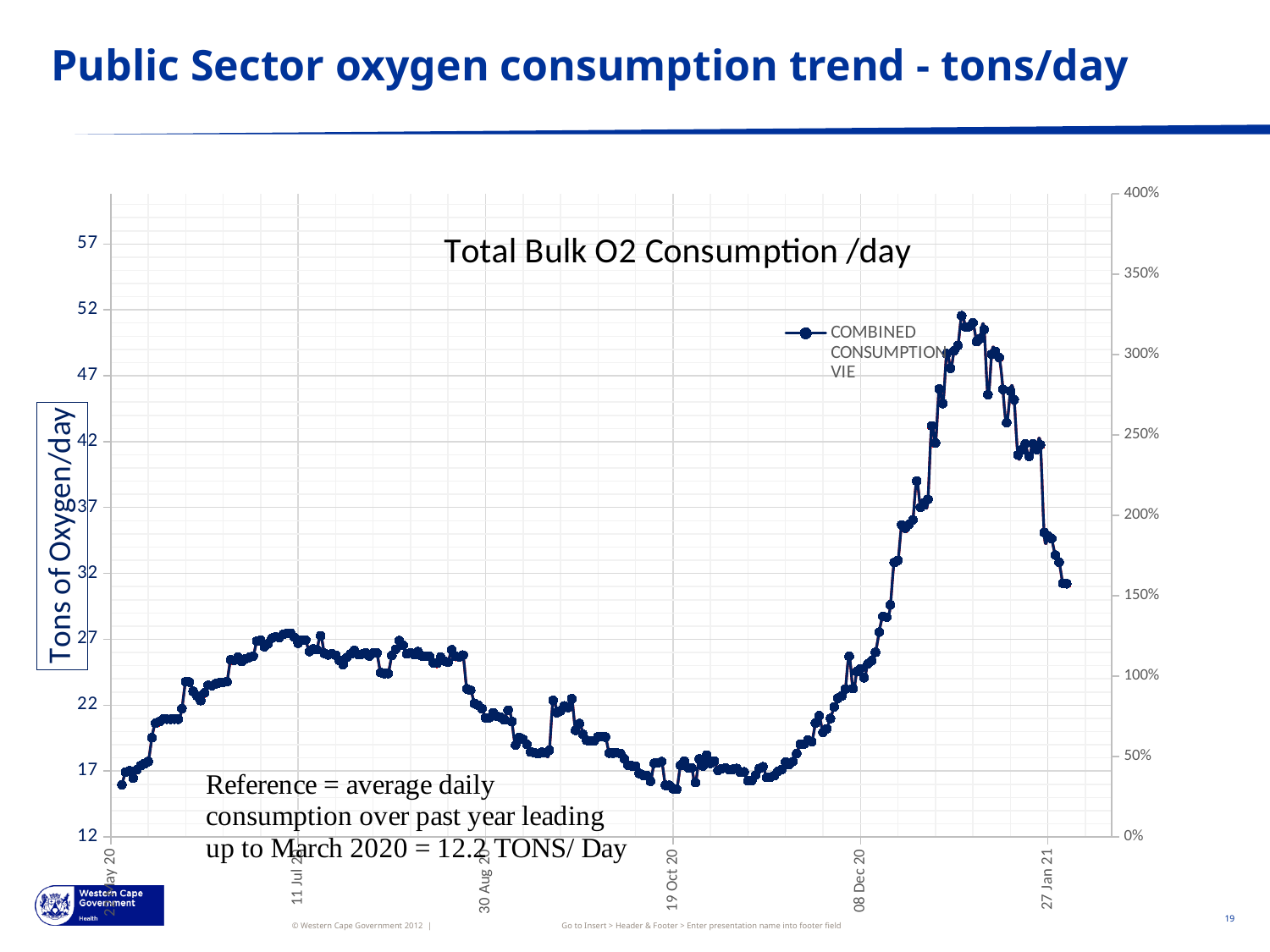
Is the peak value of the line greater or less than 47 tons/day? greater Is the value at 27 Jan 21 greater or less than 37 tons/day? less What is the label on the left vertical axis of the chart? Tons of Oxygen/day What kind of chart is shown on the slide? line chart Does the line rise or fall between 11 Jul 20 and 19 Oct 20? fall Is the value at 19 Oct 20 greater or less than 22 tons/day? less What is the title printed inside the chart area? Total Bulk O2 Consumption /day Between which two x-axis date labels does the line reach its highest point? 08 Dec 20 and 27 Jan 21 How many series does the chart's legend list? 1 Does the line rise or fall between 08 Dec 20 and its peak? rise